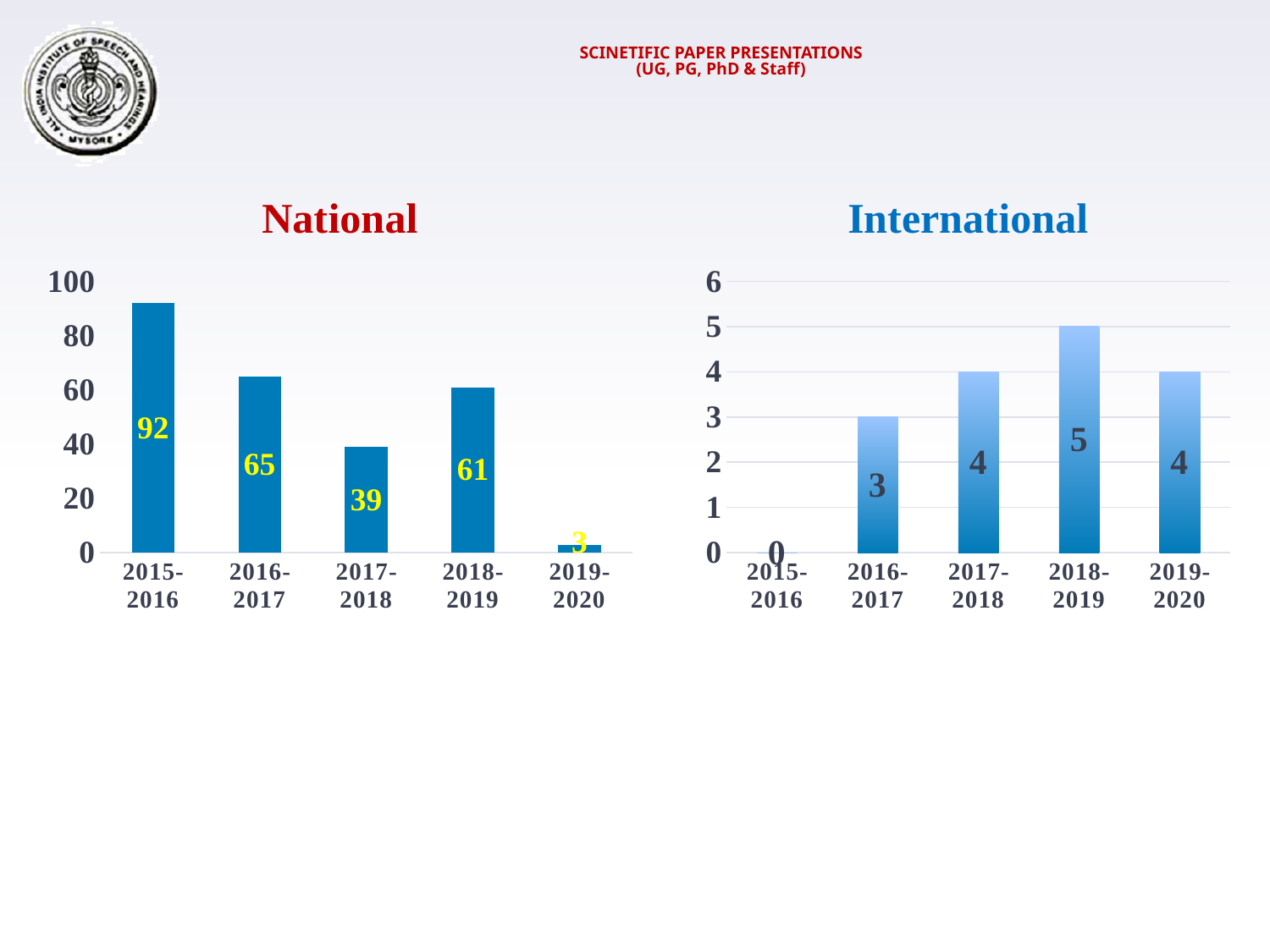
In the National chart, which is larger, the value for 2016-2017 or the value for 2018-2019? 2016-2017 In the National chart, which year has the highest value? 2015-2016 In the International chart, what is the value for 2015-2016? 0 In the International chart, which year has the highest value? 2018-2019 In the National chart, what is the value for 2015-2016? 92 In the National chart, what is the difference between the values for 2015-2016 and 2016-2017? 27 What kind of chart is the National chart? bar chart In the International chart, what is the value for 2018-2019? 5 In the International chart, what is the difference between the values for 2018-2019 and 2016-2017? 2 In the National chart, what is the value for 2017-2018? 39 How many categories are shown on the x axis of the International chart? 5 In the National chart, which year has the lowest value? 2019-2020